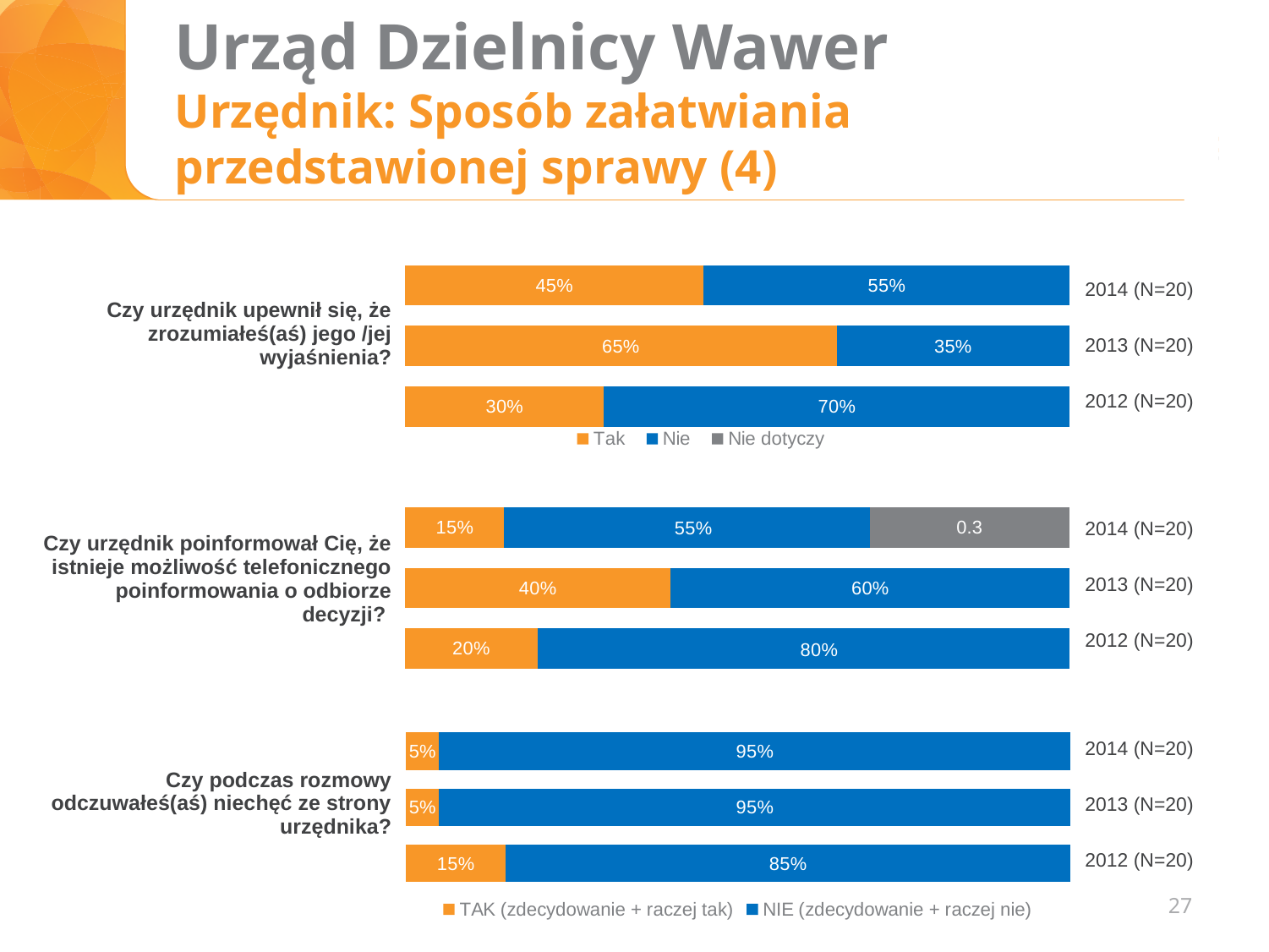
In the middle chart, which year has the lowest Tak value? 2014 (N=20) What type of chart is used on this slide? Stacked bar chart In the top chart, which year has the highest Tak value? 2013 (N=20) In the middle chart ("Czy urzędnik poinformował Cię, że istnieje możliwość telefonicznego poinformowania o odbiorze decyzji?"), what is the value for Tak in 2013 (N=20)? 40% In the top chart, what is the difference between the Tak values for 2013 and 2012? 35% In the bottom chart ("Czy podczas rozmowy odczuwałeś(aś) niechęć ze strony urzędnika?"), what is the NIE value for 2012 (N=20)? 85% How many entries does the legend of the top chart list? 3 In the middle chart, what label is printed on the grey Nie dotyczy segment for 2014 (N=20)? 0.3 In the bottom chart, is the TAK value for 2012 larger or smaller than the TAK value for 2014? larger In the top chart ("Czy urzędnik upewnił się, że zrozumiałeś(aś) jego /jej wyjaśnienia?"), what is the value for Tak in 2014 (N=20)? 45% In the top chart, what is the value for Nie in 2012 (N=20)? 70% How many year bars does the bottom chart show? 3